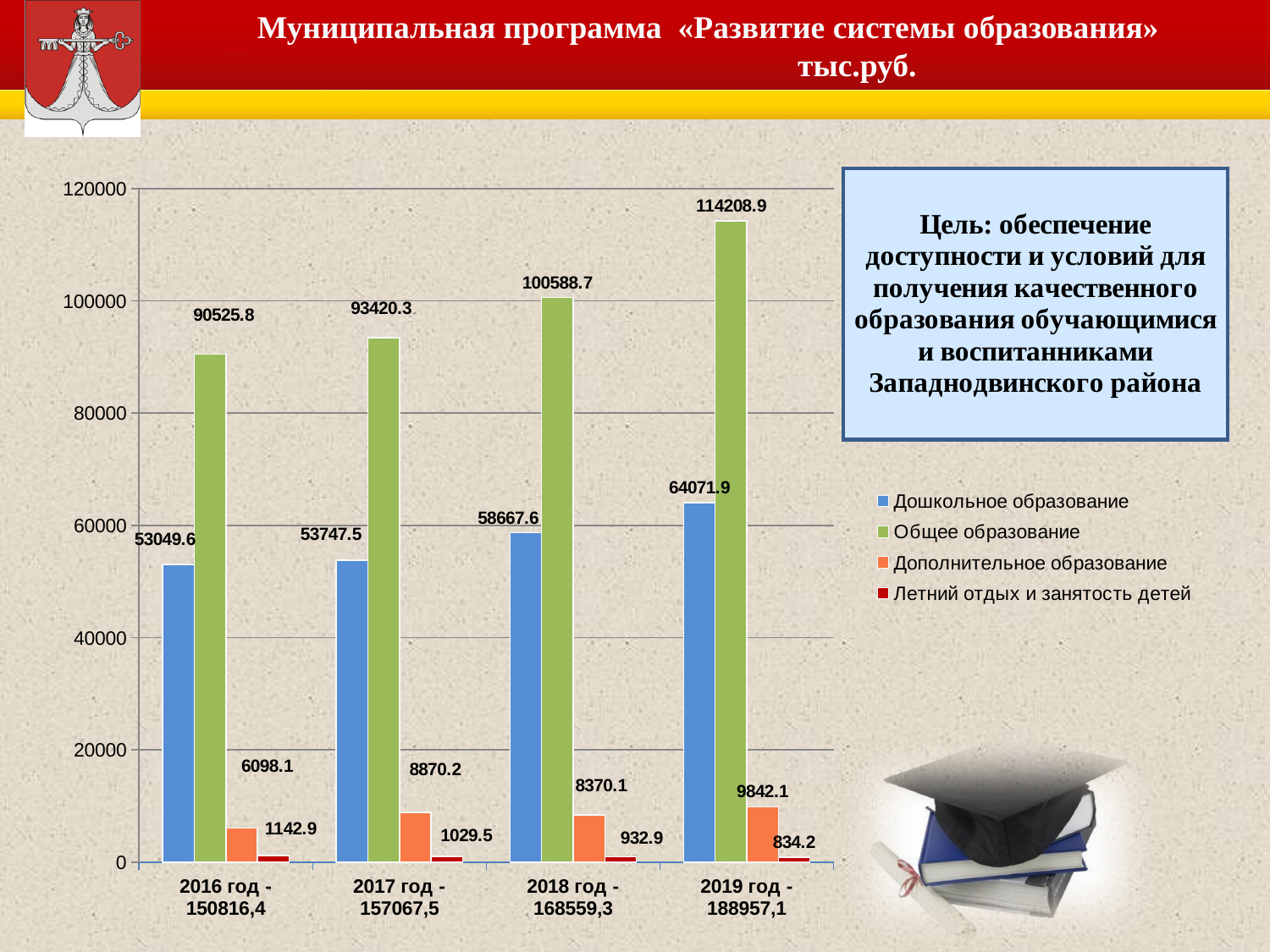
In which year is the value for Общее образование the highest? 2019 год In which year is the value for Летний отдых и занятость детей the lowest? 2019 год Is the value for Общее образование in 2018 год greater or less than 100000? greater What is the value for Дополнительное образование in 2017 год? 8870.2 What is the value for Дошкольное образование in 2016 год? 53049.6 How many years are shown on the x axis? 4 What is the value for Летний отдых и занятость детей in 2018 год? 932.9 Which is larger: Дополнительное образование in 2017 год or in 2018 год? 2017 год How many series does the legend list? 4 What is the difference between the Общее образование values for 2019 год and 2018 год? 13620.2 Does the value for Дошкольное образование rise or fall from 2016 год to 2019 год? rise What is the value for Общее образование in 2019 год? 114208.9